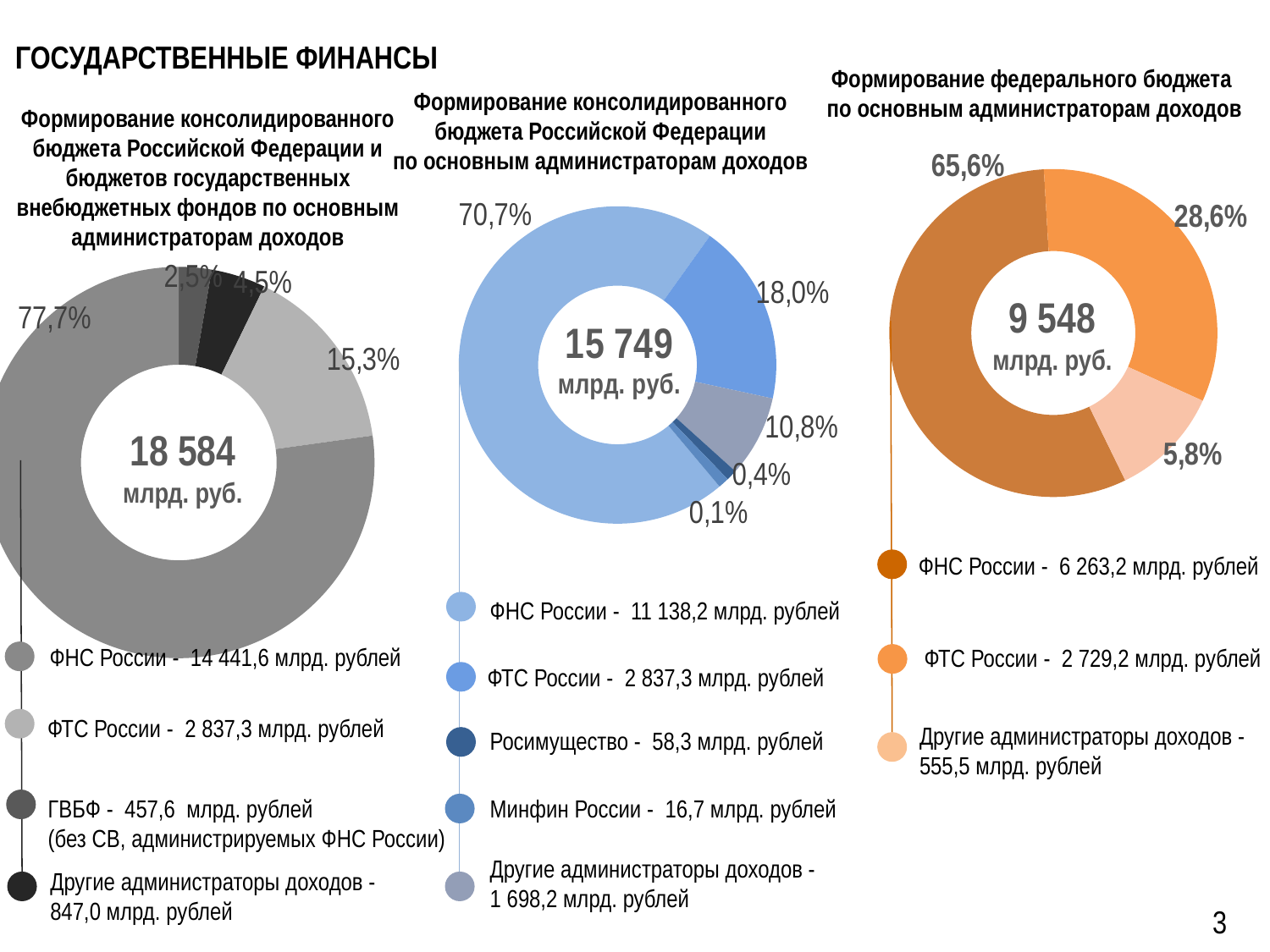
In the middle chart (consolidated budget of the Russian Federation), what total value is shown in the centre of the donut? 15 749 млрд. руб. In the left chart (consolidated budget and state extra-budgetary funds), which administrator has the largest share? ФНС России In the middle chart (consolidated budget of the Russian Federation), which administrator has the smallest share? Минфин России In the left chart (consolidated budget and state extra-budgetary funds), which is larger: the value for ГВБФ or for Другие администраторы доходов? Другие администраторы доходов What kind of chart is used for the 'Формирование федерального бюджета по основным администраторам доходов' chart? Pie (donut) chart In the left chart (consolidated budget and state extra-budgetary funds), what total value is shown in the centre of the donut? 18 584 млрд. руб. How many charts are shown on the slide? 3 In the right chart (federal budget), what share of the pie does ФНС России account for? 65,6% In the middle chart (consolidated budget of the Russian Federation), what is the value for ФТС России? 2 837,3 млрд. рублей In the right chart (federal budget), how many categories does the legend list? 3 In the middle chart (consolidated budget of the Russian Federation), what is the difference between the shares of ФТС России and Другие администраторы доходов? 7,2% In the right chart (federal budget), what total value is shown in the centre of the donut? 9 548 млрд. руб.